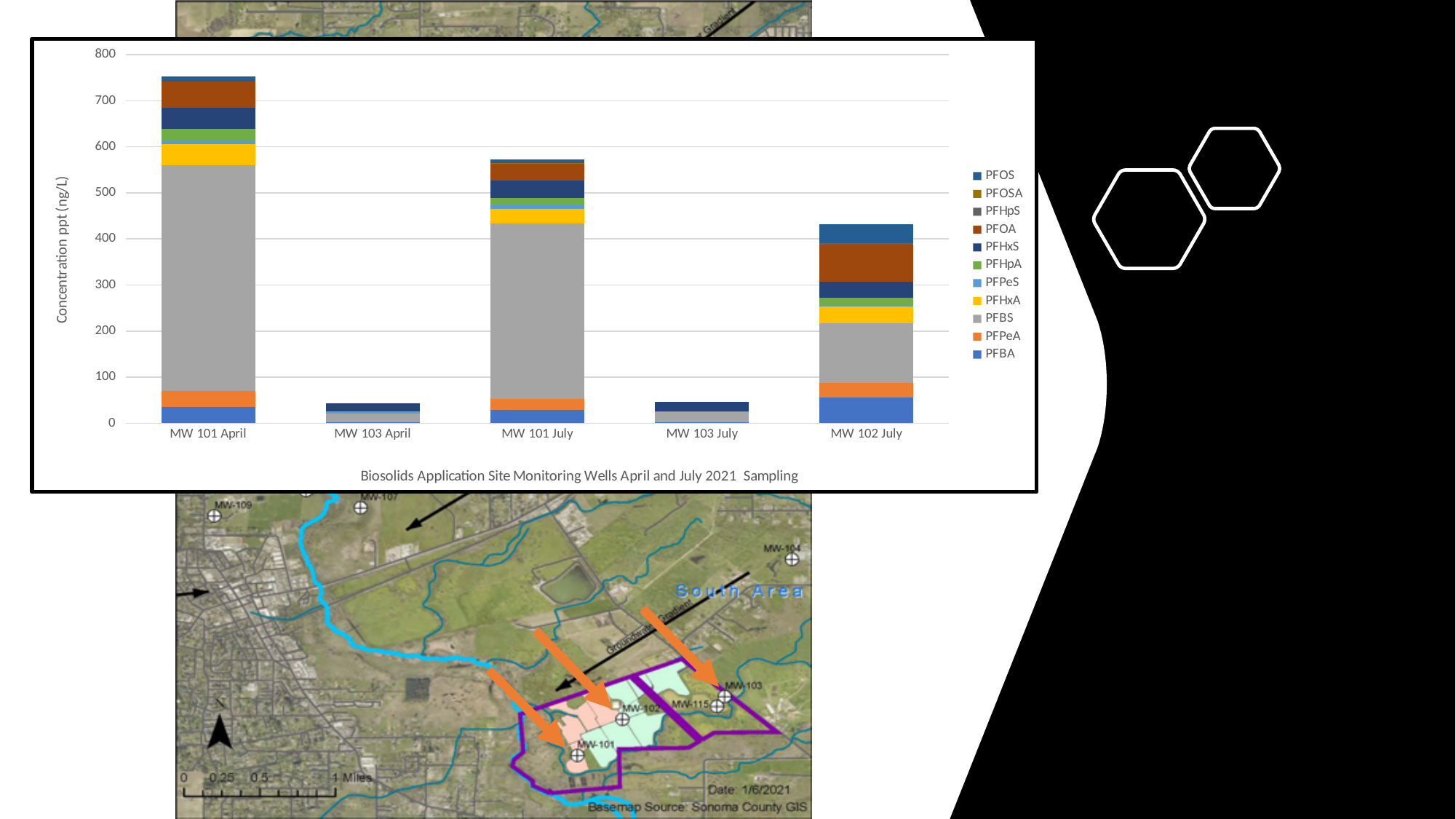
What is the title shown below the chart? Biosolids Application Site Monitoring Wells April and July 2021 Sampling How many monitoring well categories are shown on the x axis of the chart? 5 Which has a larger total concentration, MW 101 April or MW 102 July? MW 101 April Is the total concentration for MW 101 July greater or less than 500? greater How many series does the chart's legend list? 11 Is the total concentration for MW 101 April greater or less than 700? greater What kind of chart is shown on the slide? stacked bar chart Is the total concentration for MW 102 July greater or less than 400? greater What is the label on the chart's vertical axis? Concentration ppt (ng/L) Which category has the highest total concentration in the chart? MW 101 April Which has a larger total concentration, MW 101 July or MW 103 July? MW 101 July